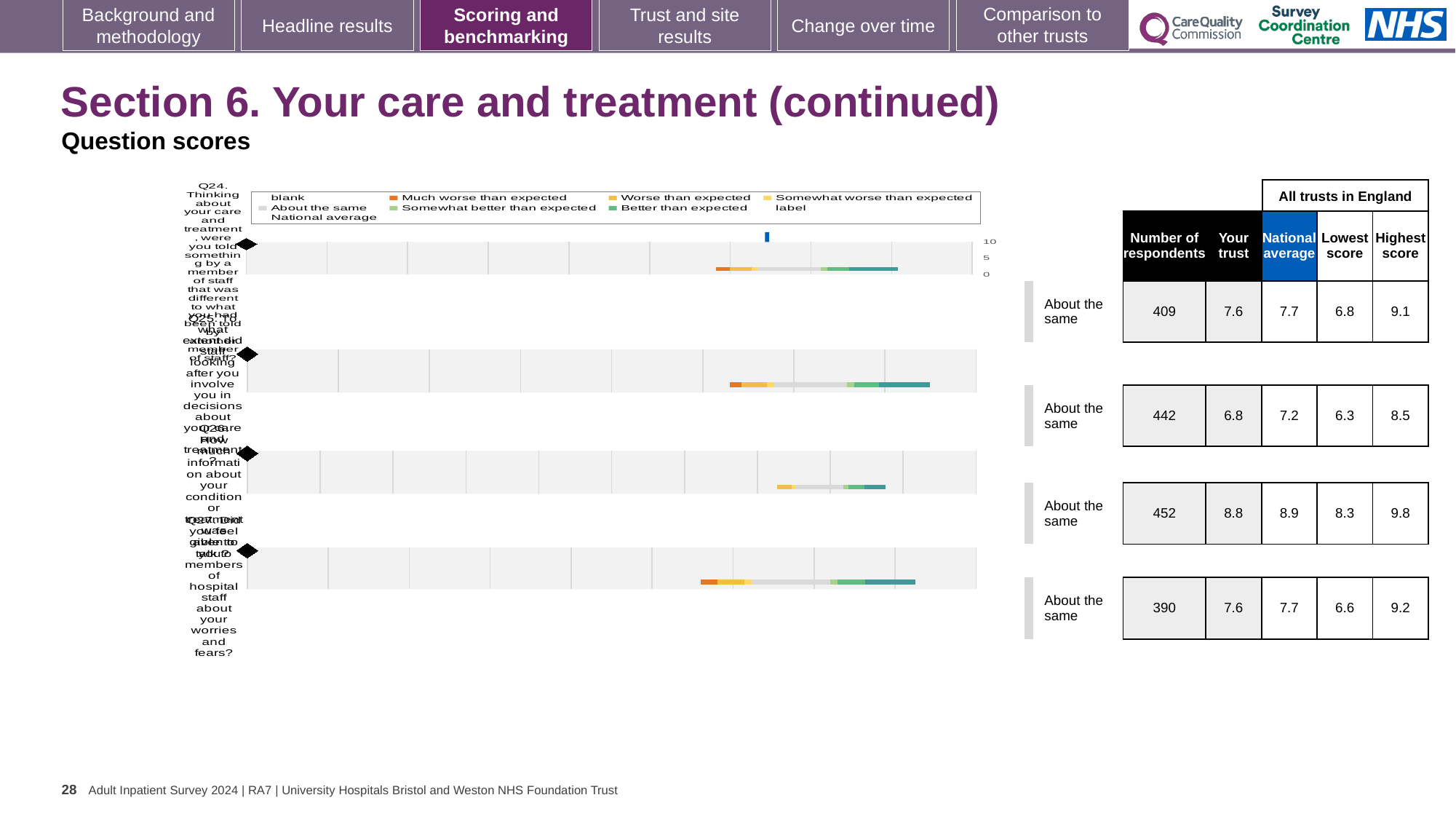
Which chart row has the highest 'Your trust' score in the table beside the charts? the third row (8.8) Is the 'Your trust' score for the third chart row greater or less than the national average for that row? less How many separate question-score charts are shown on the slide? 4 In the table beside the charts, what is the highest score for the third chart row? 9.8 What benchmark category is given for the first (top) chart? About the same In the chart legend, which category is shown in orange? Much worse than expected In the table beside the charts, how many respondents are listed for the fourth (bottom) chart row? 390 In the chart legend, which category is shown in dark teal? Better than expected What kind of chart is used for the question scores on this slide? bar chart In the table beside the charts, what is the 'Your trust' score for the first (top) chart row? 7.6 In the table beside the charts, what is the national average for the second chart row? 7.2 What is the difference between the national average and the 'Your trust' score for the second chart row? 0.4